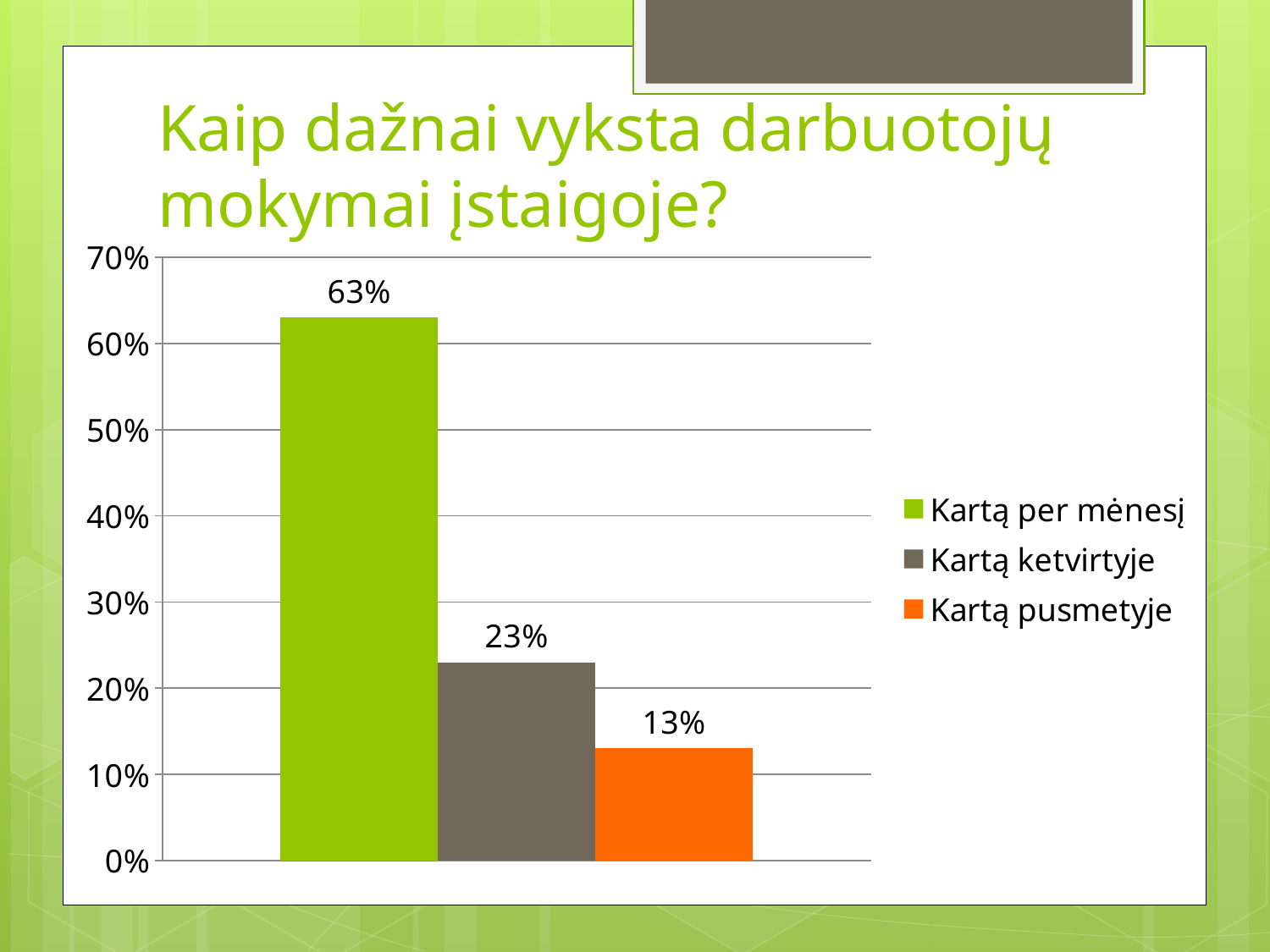
What is the value for Kartą per mėnesį? 63% What is the difference between the values for Kartą ketvirtyje and Kartą pusmetyje? 10% What kind of chart is shown on the slide? Bar chart What is the difference between the values for Kartą per mėnesį and Kartą ketvirtyje? 40% How many series does the legend list? 3 Is the value for Kartą per mėnesį greater or less than 50%? greater Which category has the lowest value? Kartą pusmetyje What is the value for Kartą ketvirtyje? 23% What colour is the bar for Kartą pusmetyje? Orange Which is larger, the value for Kartą ketvirtyje or the value for Kartą pusmetyje? Kartą ketvirtyje Which category has the highest value? Kartą per mėnesį What is the value for Kartą pusmetyje? 13%